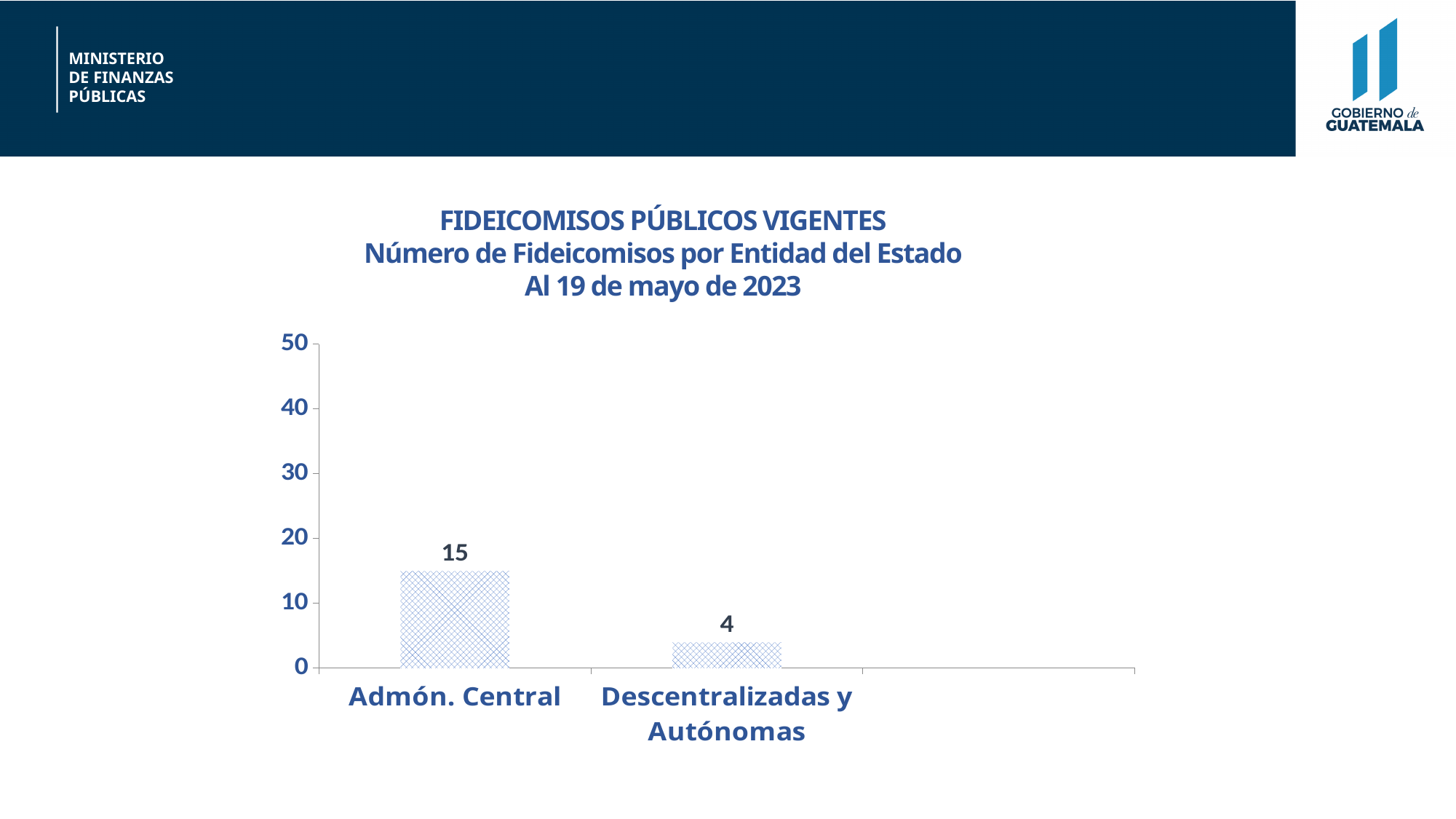
What kind of chart is shown on the slide? bar chart Which category has the highest value? Admón. Central What is the value for Descentralizadas y Autónomas? 4 How many categories are shown on the chart? 2 Which category has the lowest value? Descentralizadas y Autónomas Which is larger, the value for Admón. Central or the value for Descentralizadas y Autónomas? Admón. Central What is the date given in the chart title? 19 de mayo de 2023 What is the value for Admón. Central? 15 Is the value for Descentralizadas y Autónomas greater or less than 10? less Is the value for Admón. Central greater or less than 20? less What is the difference between the values for Admón. Central and Descentralizadas y Autónomas? 11 What is the total of the values for both categories? 19